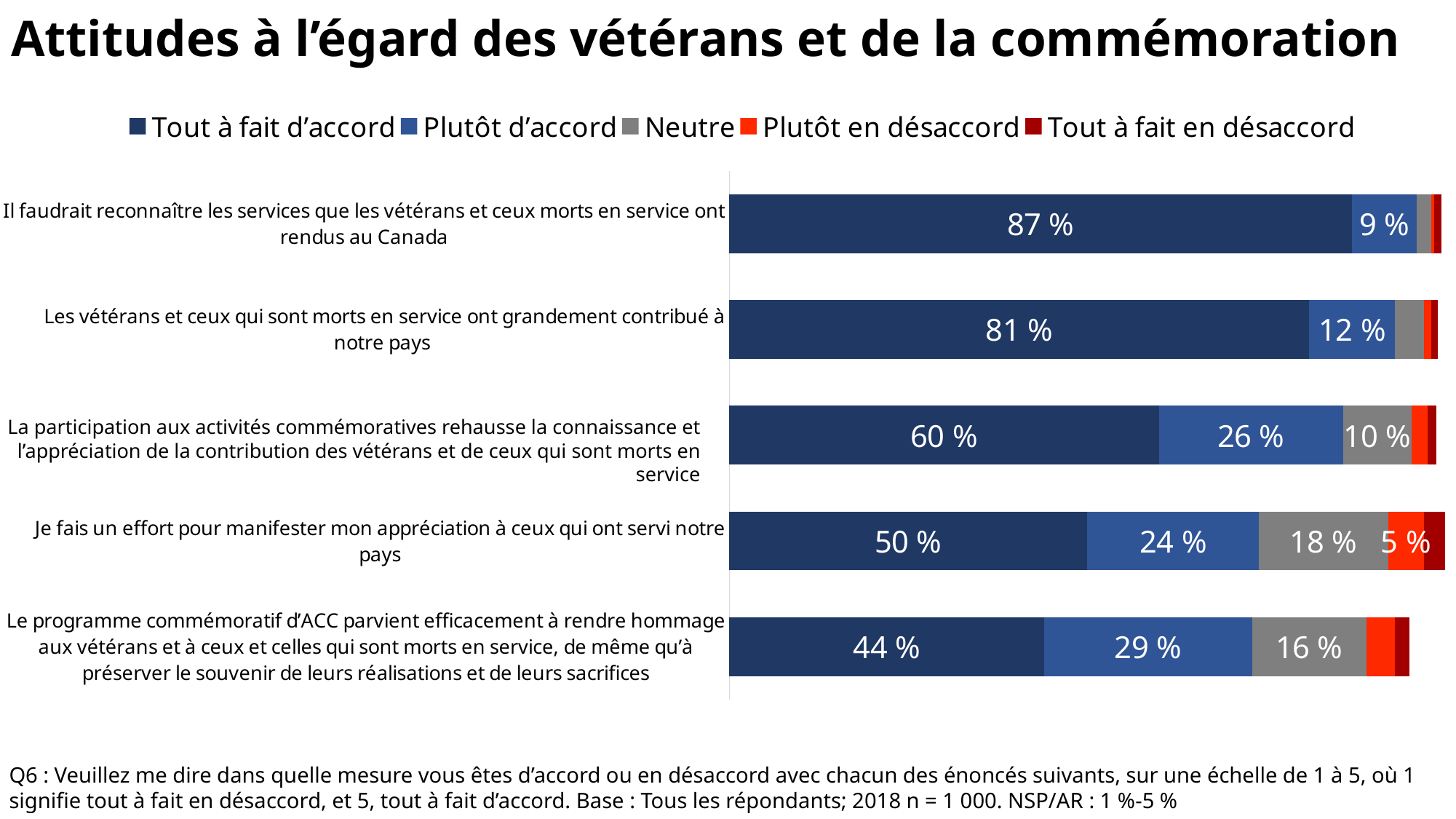
Which legend entry is shown in grey? Neutre How many statements (categories) are plotted in the chart? 5 What is the 'Tout à fait d'accord' value for 'Il faudrait reconnaître les services que les vétérans et ceux morts en service ont rendus au Canada'? 87 % What is the 'Plutôt en désaccord' value for 'Je fais un effort pour manifester mon appréciation à ceux qui ont servi notre pays'? 5 % Which is larger: the 'Neutre' value for 'La participation aux activités commémoratives...' or the 'Neutre' value for 'Le programme commémoratif d'ACC...'? Le programme commémoratif d'ACC... What kind of chart is shown on the slide? Stacked bar chart What is the 'Plutôt d'accord' value for 'Les vétérans et ceux qui sont morts en service ont grandement contribué à notre pays'? 12 % What is the 'Neutre' value for 'Je fais un effort pour manifester mon appréciation à ceux qui ont servi notre pays'? 18 % What is the difference between the 'Tout à fait d'accord' values for 'Il faudrait reconnaître les services...' (87 %) and 'Les vétérans et ceux qui sont morts en service ont grandement contribué à notre pays' (81 %)? 6 % How many series does the legend list? 5